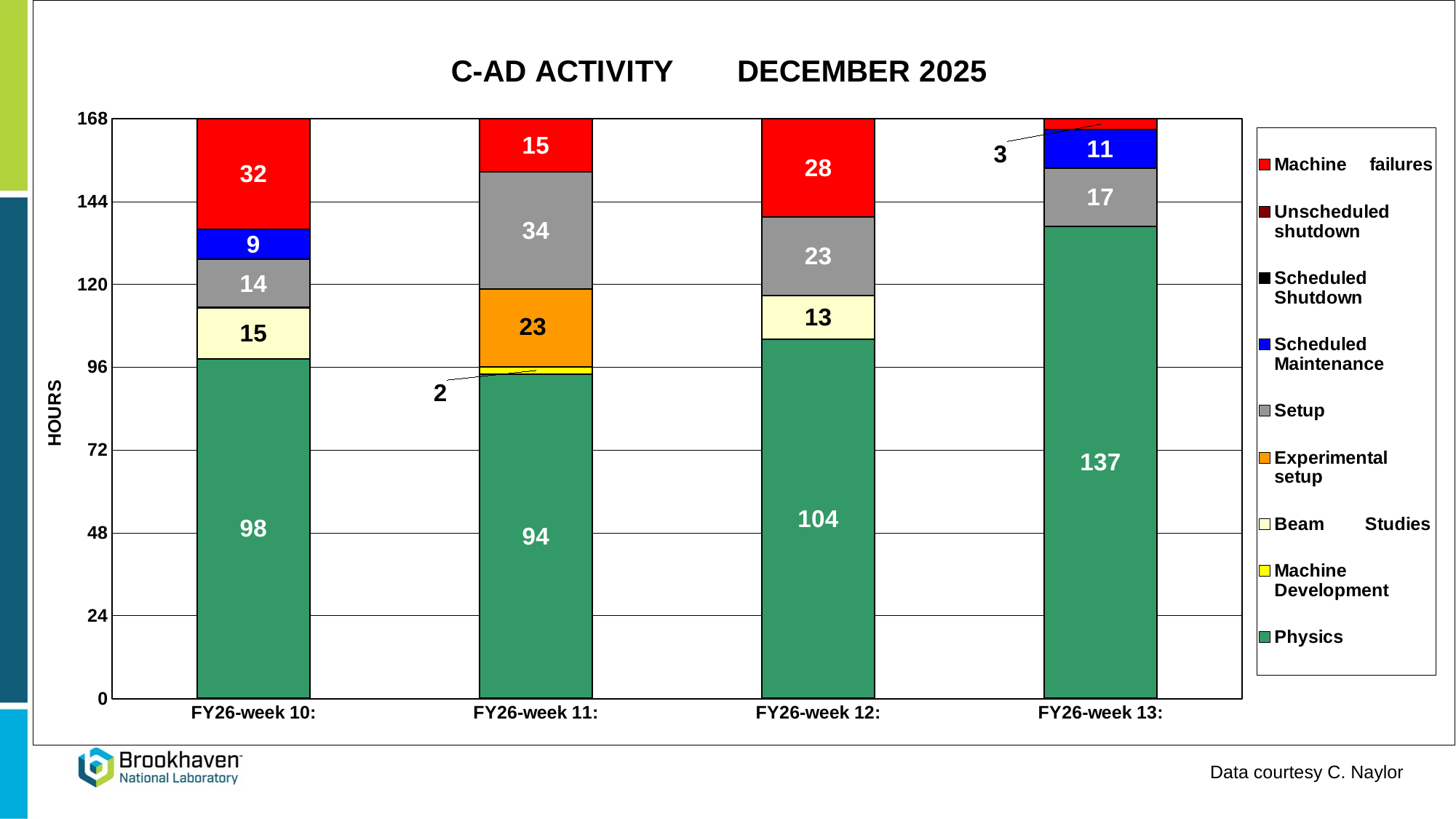
What kind of chart is shown on the slide? Stacked bar chart How many hours of Experimental setup are shown for FY26-week 11? 23 What is the difference in Physics hours between FY26-week 13 and FY26-week 10? 39 How many hours of Physics are shown for FY26-week 13? 137 Which week has more Setup hours, FY26-week 11 or FY26-week 12? FY26-week 11 How many series does the legend list? 9 How many weeks are shown on the x axis? 4 What is the Machine failures value for FY26-week 10? 32 Which week has the highest Physics hours? FY26-week 13 What is the total of the stacked bar for FY26-week 10? 168 Which week has the lowest Machine failures hours? FY26-week 13 What is the title of the chart? C-AD ACTIVITY DECEMBER 2025